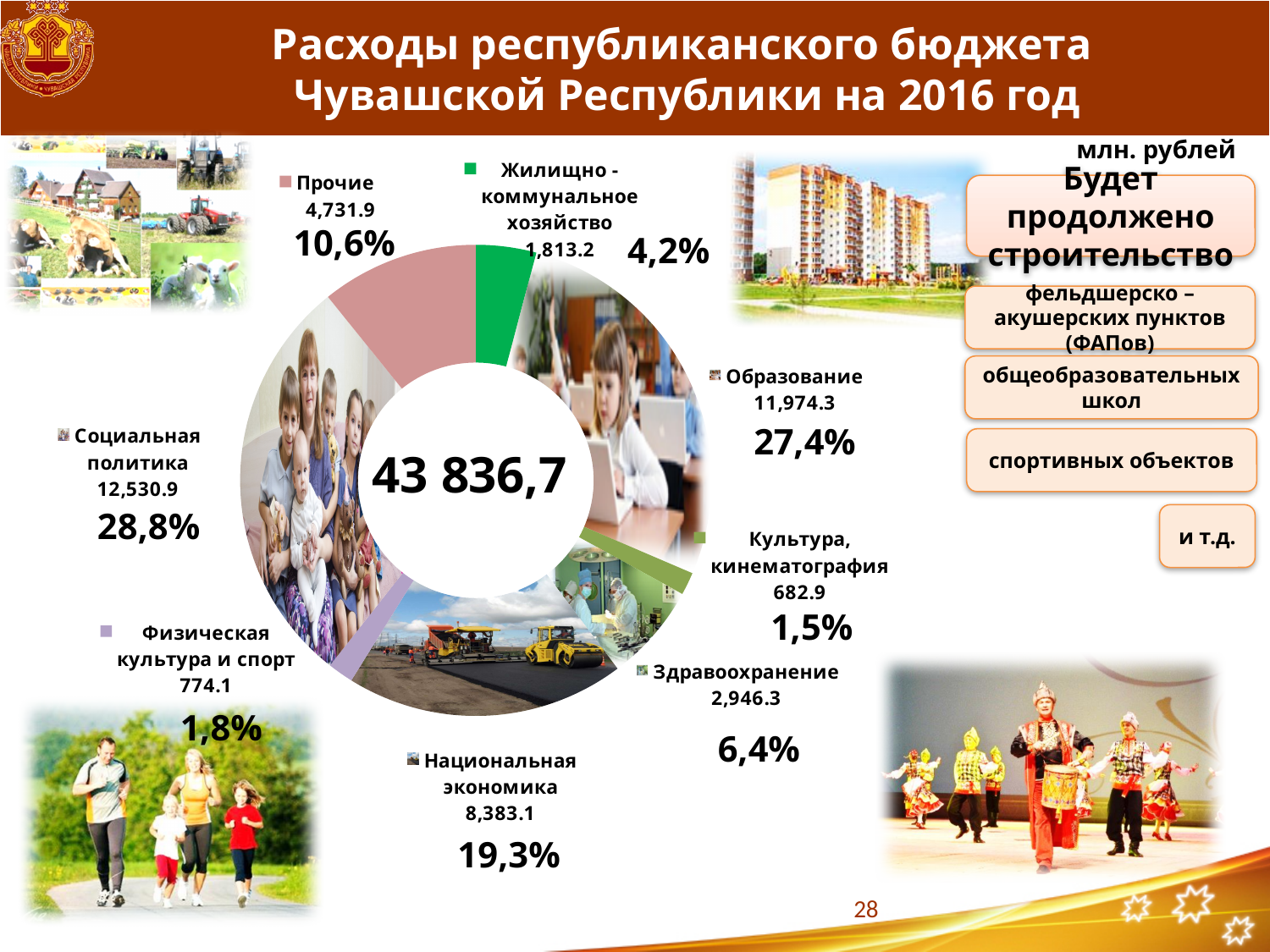
Which category has the smallest value? Культура, кинематография What percentage share does Социальная политика have? 28,8% What total value is shown in the centre of the chart? 43 836,7 What is the difference between the values for Образование and Здравоохранение? 9,028.0 How many categories does the chart show? 8 What percentage share does Национальная экономика have? 19,3% What is the value for Образование? 11,974.3 What is the value for Здравоохранение? 2,946.3 What unit is stated for the values on the slide? млн. рублей Which is larger, the value for Национальная экономика or the value for Прочие? Национальная экономика Which category has the largest value? Социальная политика What kind of chart is shown on the slide? Pie (doughnut) chart